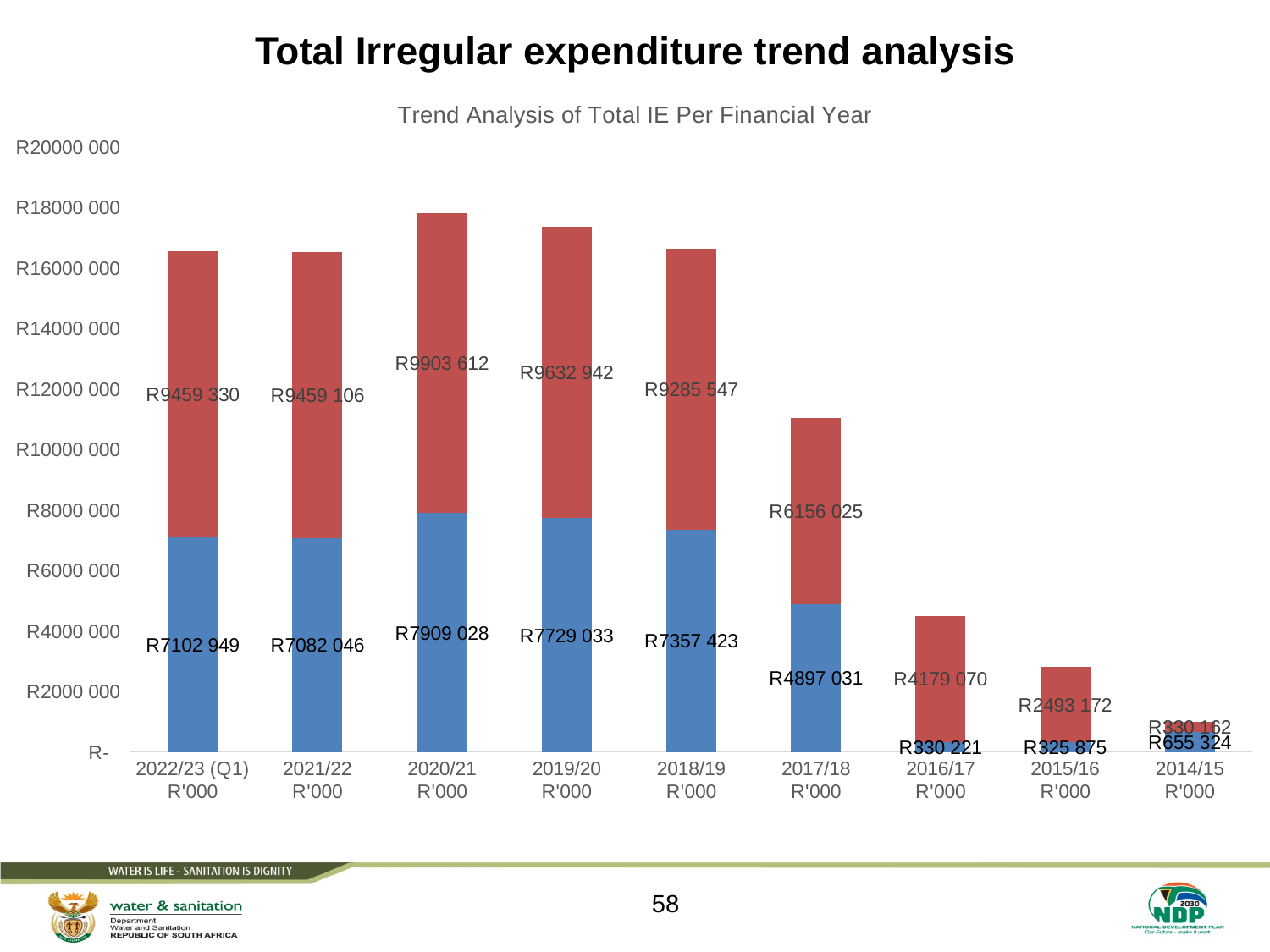
What is the title shown above the chart area? Trend Analysis of Total IE Per Financial Year What type of chart is shown on the slide? Stacked bar chart Is the total of the stacked bar for 2016/17 greater or less than R6000 000? less What is the total of the stacked bar for 2017/18? R11053 056 What is the value of the blue segment for 2020/21? R7909 028 What is the difference between the red segment values for 2020/21 and 2019/20? R270 670 How many financial years are shown on the x axis of the chart? 9 Which financial year has the lowest blue segment value? 2015/16 What is the value of the blue segment for 2015/16? R325 875 Which is larger, the blue segment for 2019/20 or the blue segment for 2018/19? 2019/20 What is the value of the red segment for 2017/18? R6156 025 Which financial year has the highest red segment value? 2020/21